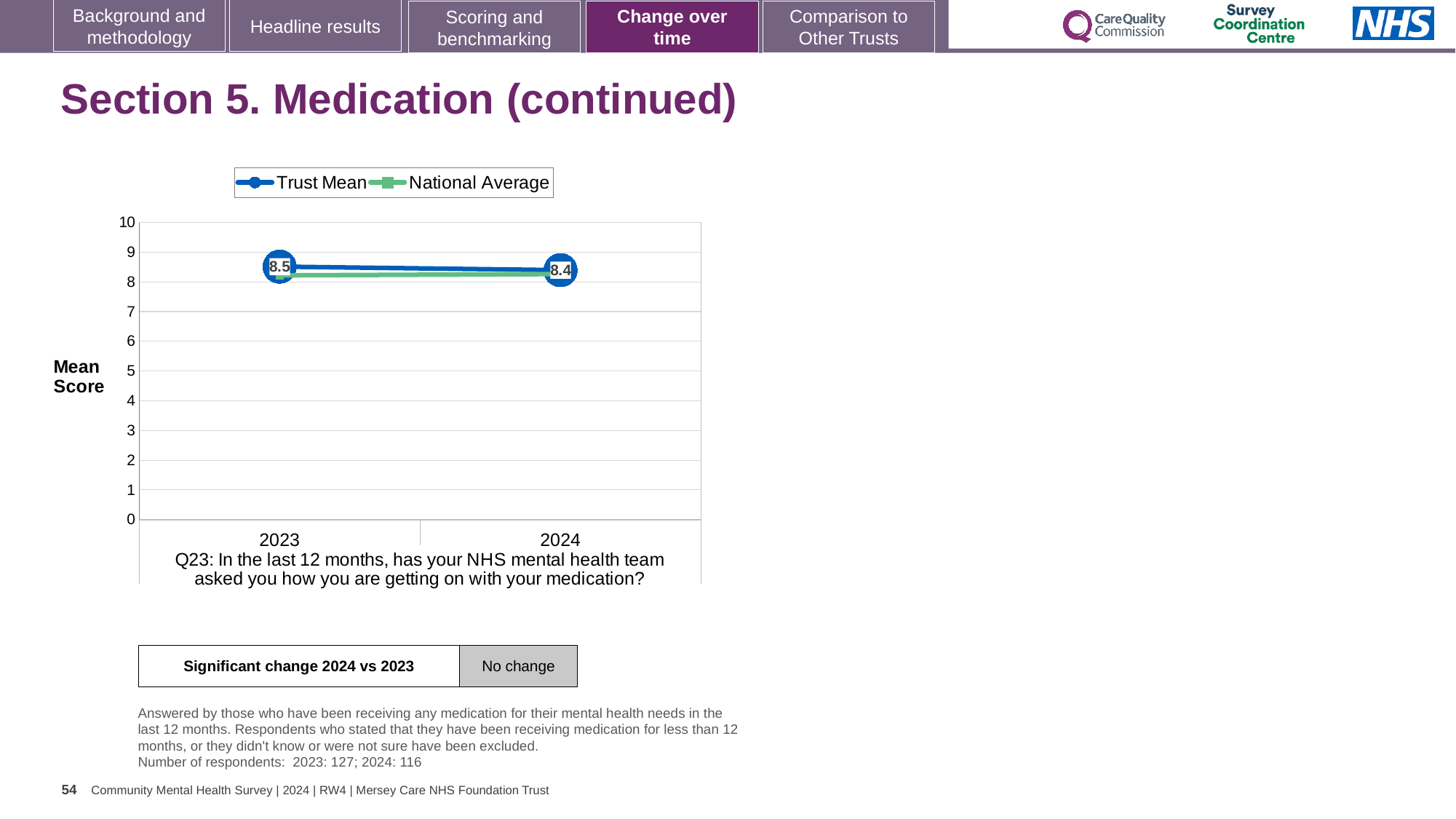
How many years are plotted on the x axis? 2 Is the National Average value for 2024 greater or less than 7? greater Is the National Average value for 2023 greater or less than 9? less What is the Trust Mean value for 2024? 8.4 What kind of chart is shown on the slide? line chart What is the label on the y axis of the chart? Mean Score Which year has the higher Trust Mean, 2023 or 2024? 2023 What is the Trust Mean value for 2023? 8.5 What are the two series named in the legend? Trust Mean and National Average How many series does the legend list? 2 What is the difference between the Trust Mean in 2023 and in 2024? 0.1 Does the Trust Mean rise or fall from 2023 to 2024? fall